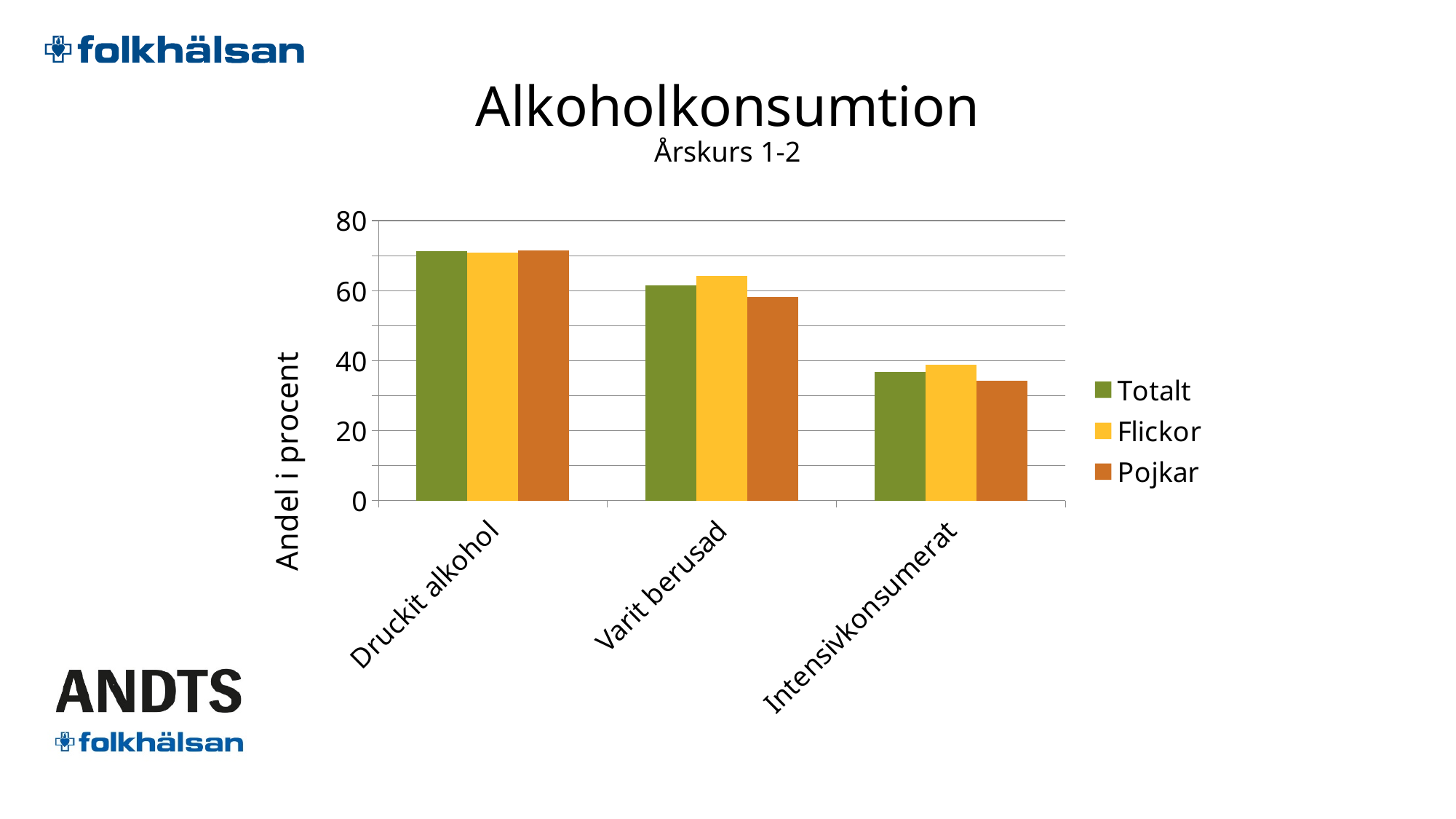
Is the value for Flickor in Varit berusad greater or less than 60? greater Which category has the highest value for Totalt? Druckit alkohol How many series does the legend list? 3 For Intensivkonsumerat, which is larger: Flickor or Pojkar? Flickor What is the label of the vertical axis of the chart? Andel i procent Do the Totalt values rise or fall from left to right across the categories? fall How many categories are shown on the x axis of the chart? 3 Is the value for Totalt in Druckit alkohol greater or less than 60? greater Which category has the lowest value for Pojkar? Intensivkonsumerat Is the value for Pojkar in Intensivkonsumerat greater or less than 40? less For Varit berusad, which is larger: Flickor or Pojkar? Flickor What kind of chart is shown on the slide? bar chart